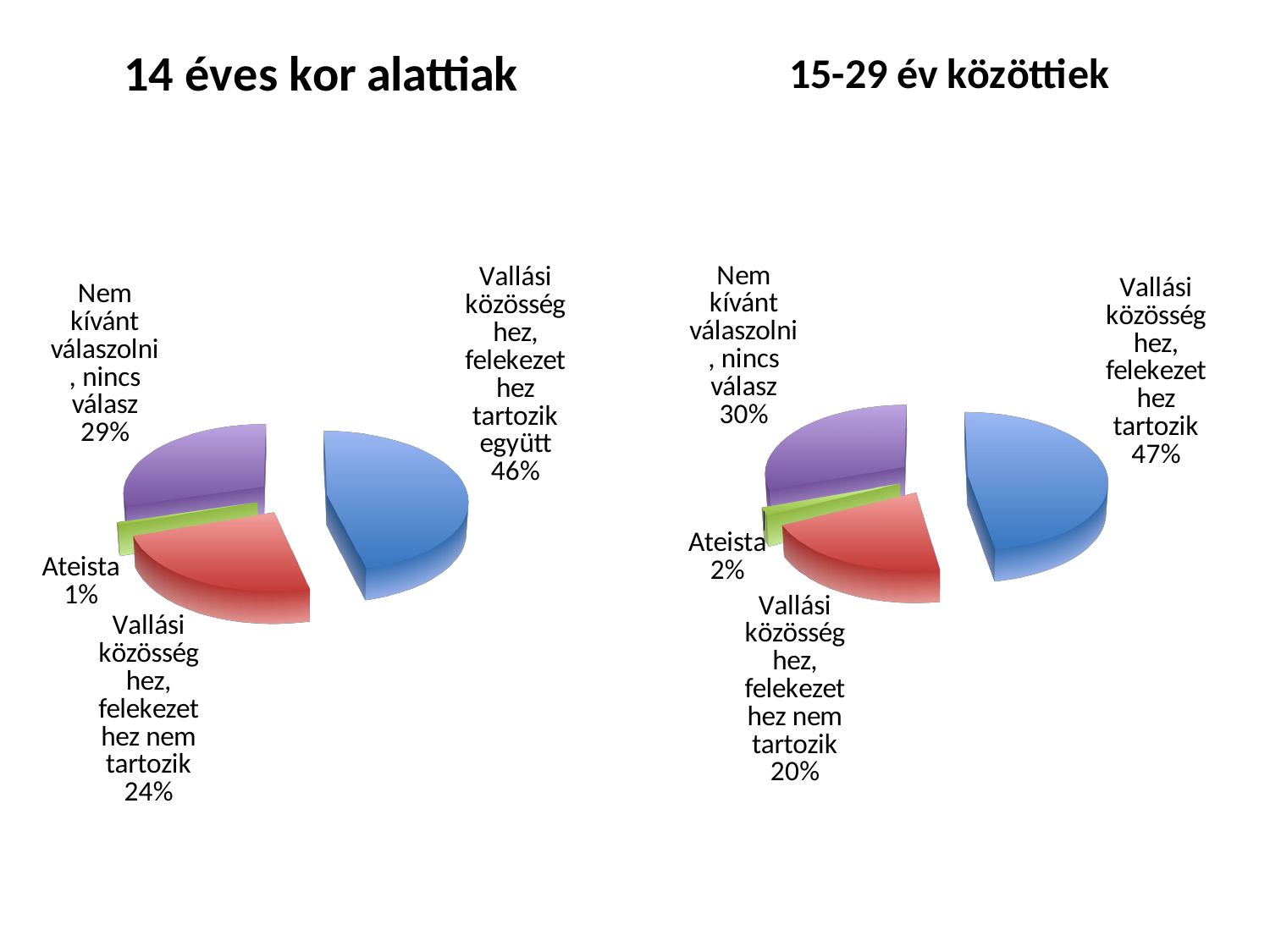
In the '15-29 év közöttiek' chart, what share is labelled for 'Ateista'? 2% In the '15-29 év közöttiek' chart, what share is labelled for 'Vallási közösséghez, felekezethez tartozik'? 47% In the '15-29 év közöttiek' chart, which slice is the smallest? Ateista In the '14 éves kor alattiak' chart, what share is labelled for 'Ateista'? 1% In the '14 éves kor alattiak' chart, which slice is the largest? Vallási közösséghez, felekezethez tartozik együtt In the '15-29 év közöttiek' chart, what share is labelled for 'Vallási közösséghez, felekezethez nem tartozik'? 20% In the '15-29 év közöttiek' chart, what is the difference between the 'Nem kívánt válaszolni, nincs válasz' share and the 'Vallási közösséghez, felekezethez nem tartozik' share? 10% How many slices does the '14 éves kor alattiak' chart have? 4 In the '14 éves kor alattiak' chart, what share is labelled for 'Nem kívánt válaszolni, nincs válasz'? 29% What kind of chart is the '15-29 év közöttiek' chart? Pie chart In the '14 éves kor alattiak' chart, what share is labelled for 'Vallási közösséghez, felekezethez nem tartozik'? 24% In the '14 éves kor alattiak' chart, which slice is the smallest? Ateista